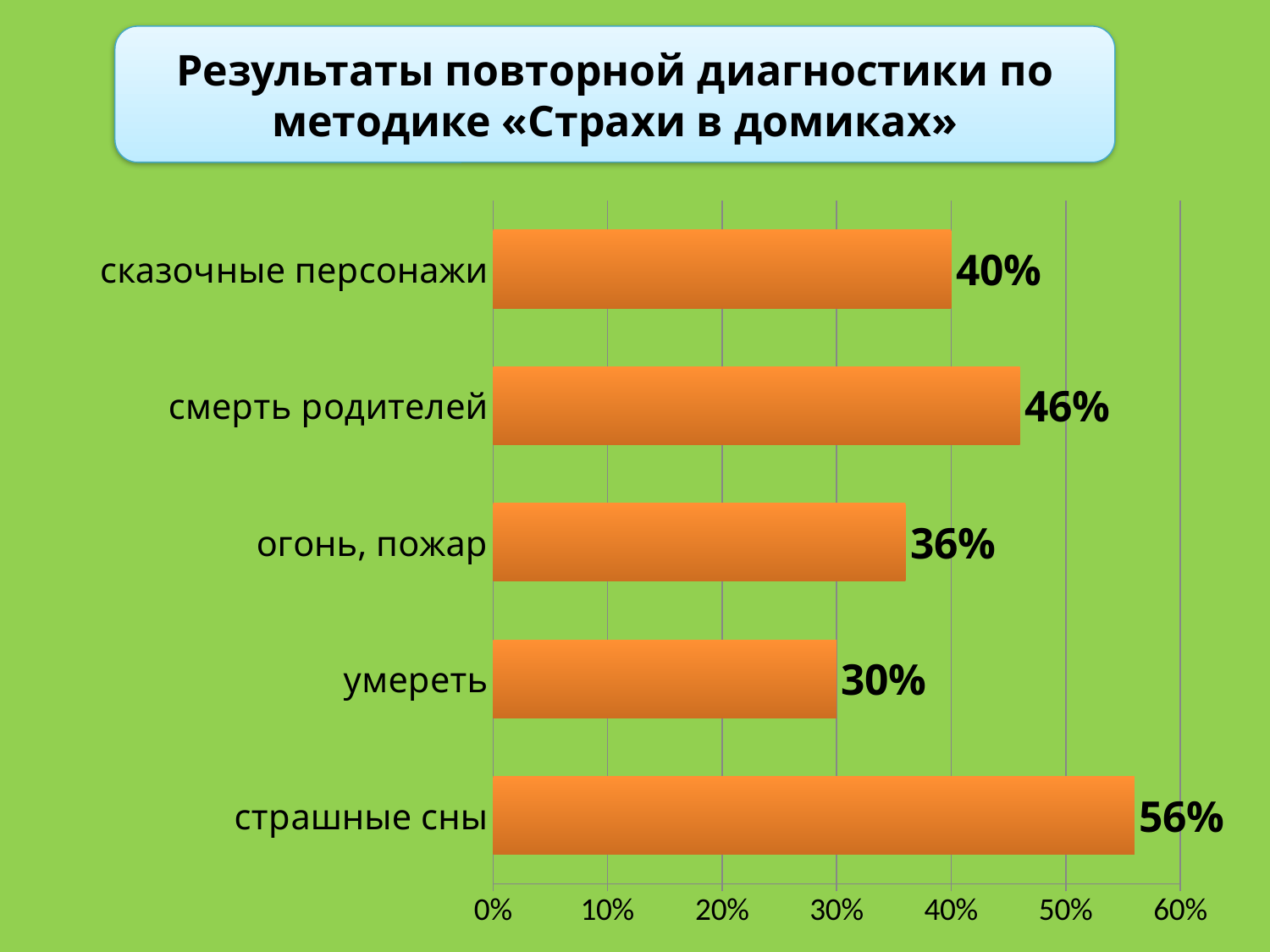
Which category has the lowest value? умереть What is the title of the slide? Результаты повторной диагностики по методике «Страхи в домиках» What kind of chart is shown on the slide? bar chart What is the difference between the values for «страшные сны» and «умереть»? 26% How many categories are shown in the chart? 5 Which is larger, the value for «сказочные персонажи» or the value for «огонь, пожар»? сказочные персонажи What is the value for «огонь, пожар»? 36% What is the difference between the values for «смерть родителей» and «сказочные персонажи»? 6% What is the value for «умереть»? 30% What is the value for «страшные сны»? 56% Which category has the highest value? страшные сны What is the value for «смерть родителей»? 46%